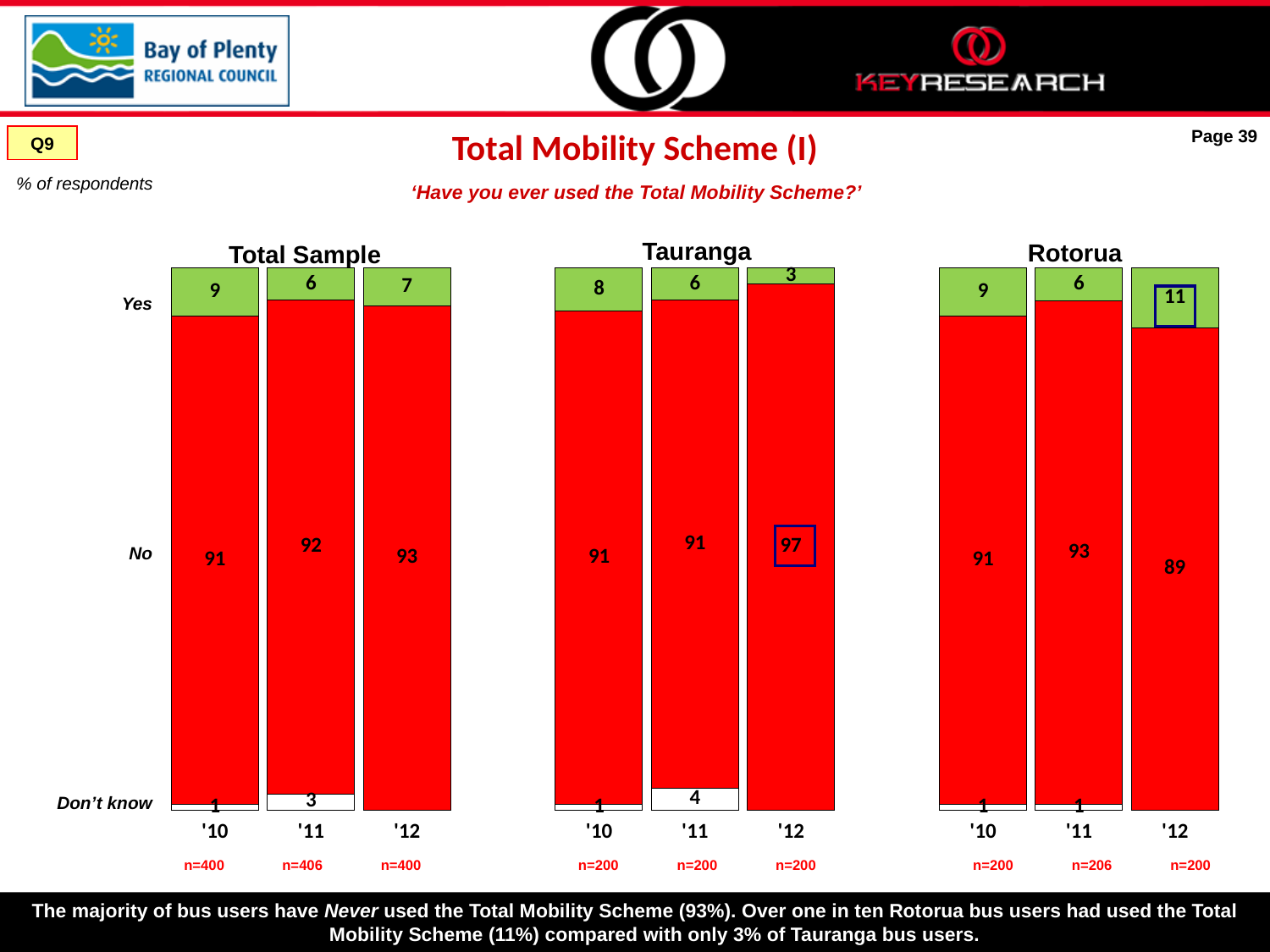
What is the sample size (n) shown under the '11 bar in the Rotorua chart? n=206 In the Tauranga chart, which year has the lowest 'Yes' value? '12 How many years are shown on the x axis of the Tauranga chart? 3 In the Rotorua chart, what is the 'Yes' value for '12? 11 Is the 'Yes' value for '12 larger in the Rotorua chart or the Tauranga chart? Rotorua In the Total Sample chart, what percentage of respondents answered 'No' in '12? 93 In the Tauranga chart, what is the 'Yes' value for '12? 3 In the Tauranga chart, what is the 'Don't know' value for '11? 4 In the Rotorua chart, which year has the highest 'Yes' value? '12 In the Total Sample chart, does the 'No' value rise or fall from '10 to '12? Rise What type of chart is used for the Total Sample data? Stacked bar chart In the Total Sample chart, what is the difference between the 'No' values for '12 and '10? 2